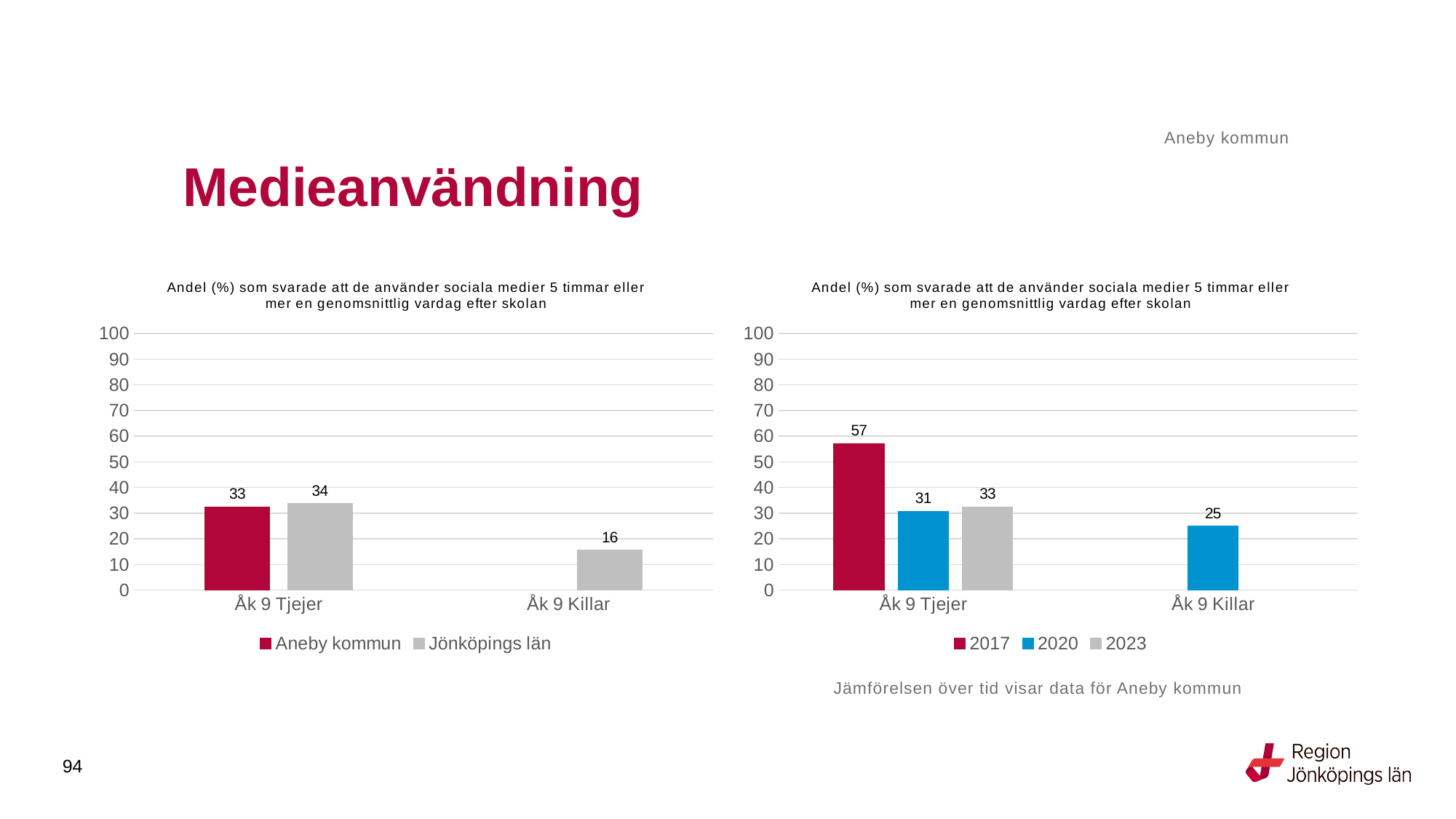
In the right chart, what is the value for 2020 for Åk 9 Killar? 25 In the left chart, is the value for Jönköpings län for Åk 9 Killar greater or less than 20? less In the left chart, what is the value for Aneby kommun for Åk 9 Tjejer? 33 In the right chart, which year has the highest value for Åk 9 Tjejer? 2017 In the left chart, how many series does the legend list? 2 In the right chart, how many series does the legend list? 3 In the right chart, which is larger for Åk 9 Tjejer, the 2020 value or the 2023 value? 2023 In the right chart, what is the difference between the 2017 and 2020 values for Åk 9 Tjejer? 26 What kind of chart is the right chart? Bar chart In the right chart, what is the value for 2017 for Åk 9 Tjejer? 57 In the left chart, what is the difference between Jönköpings län and Aneby kommun for Åk 9 Tjejer? 1 In the left chart, what is the value for Jönköpings län for Åk 9 Killar? 16